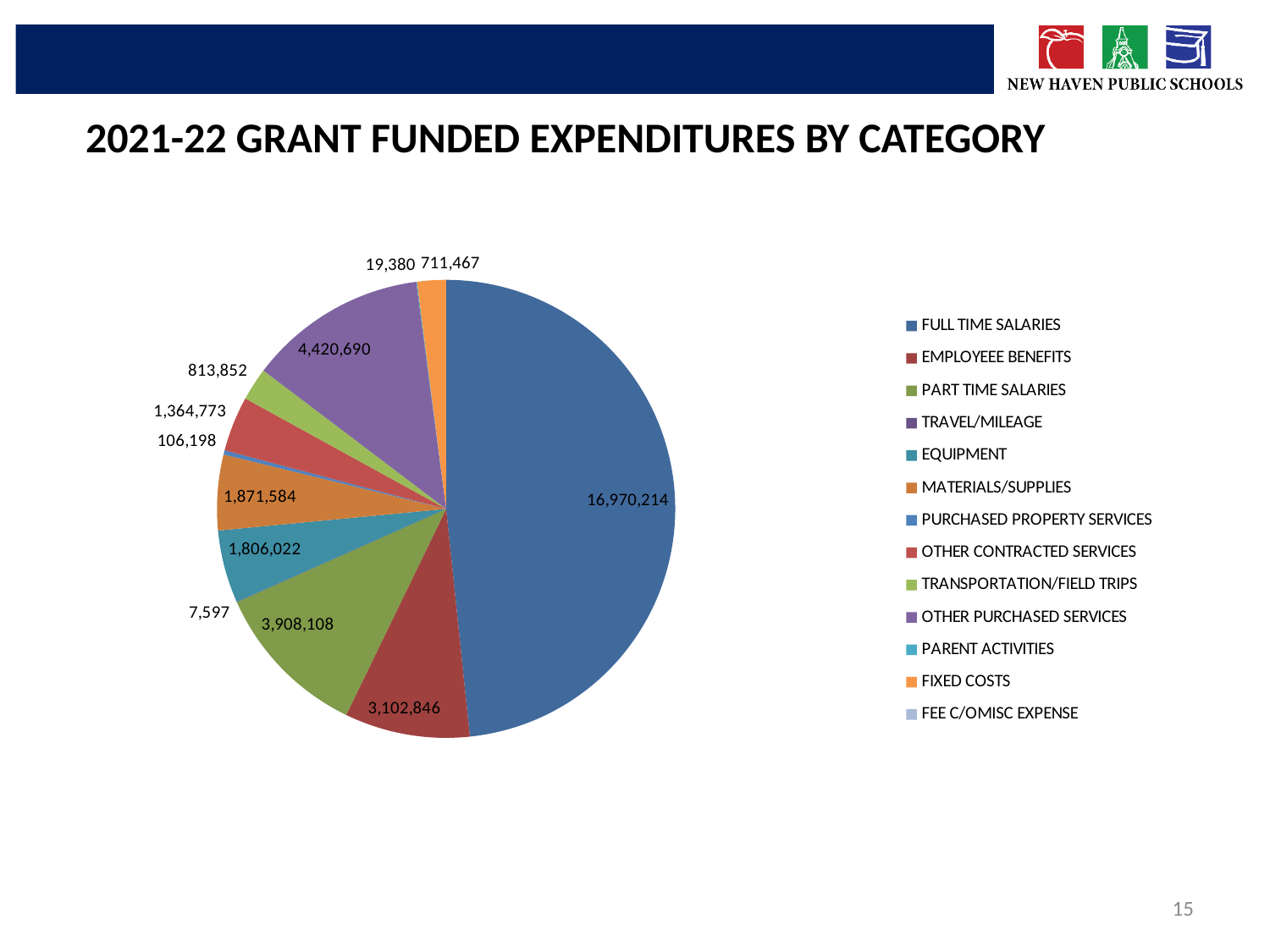
How many categories does the legend list? 13 What is the value for FIXED COSTS? 711,467 What is the difference between OTHER PURCHASED SERVICES and PART TIME SALARIES? 512,582 What is the value for PART TIME SALARIES? 3,908,108 What is the difference between PART TIME SALARIES and EMPLOYEEE BENEFITS? 805,262 What type of chart is shown on the slide? Pie chart What is the value for OTHER PURCHASED SERVICES? 4,420,690 Which category has the largest slice of the pie? FULL TIME SALARIES Which is larger, OTHER PURCHASED SERVICES or PART TIME SALARIES? OTHER PURCHASED SERVICES What is the value for FULL TIME SALARIES? 16,970,214 What is the title of the chart? 2021-22 GRANT FUNDED EXPENDITURES BY CATEGORY What is the value for EMPLOYEEE BENEFITS? 3,102,846